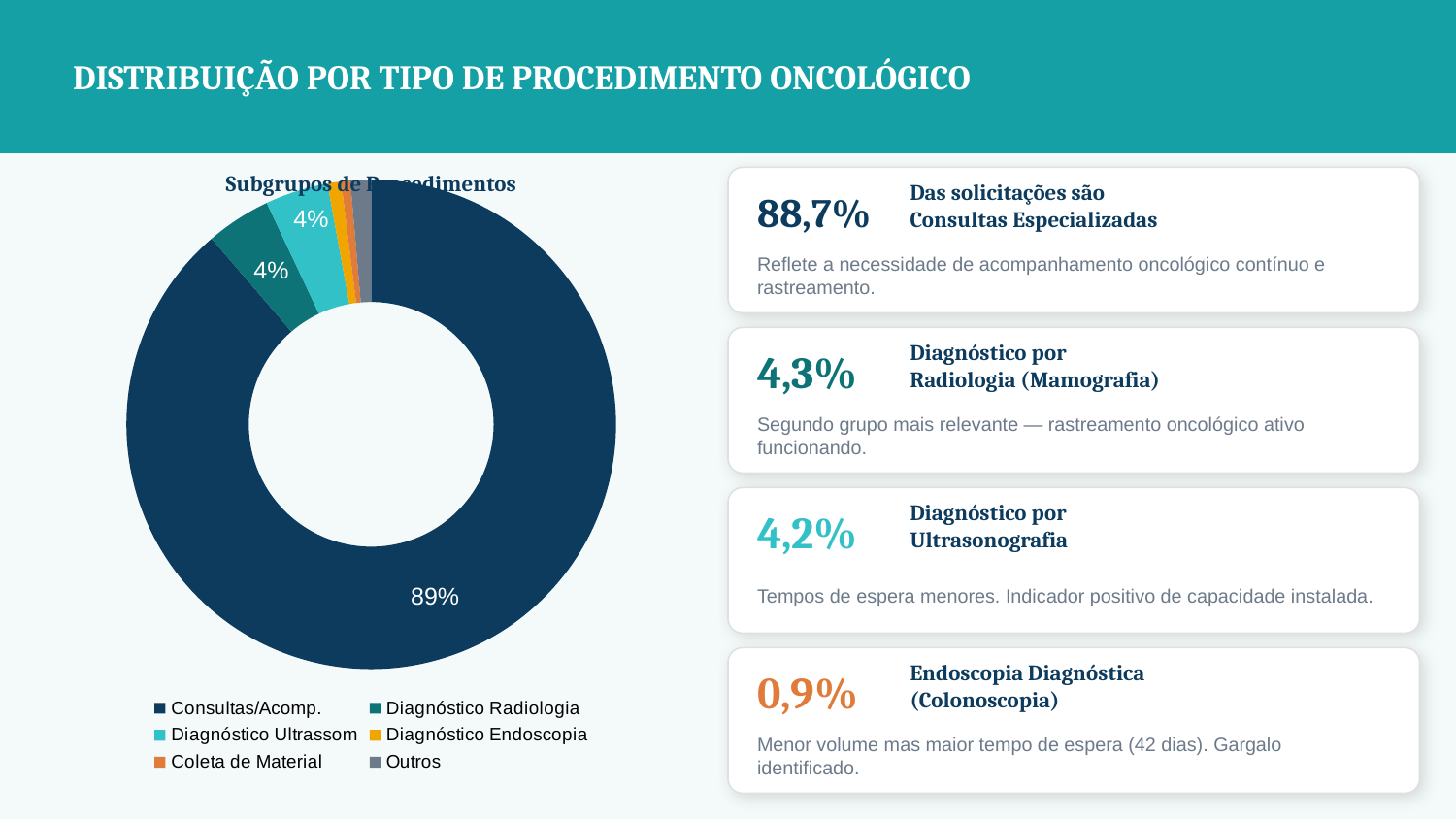
Is the share for Consultas/Acomp. greater or less than 50%? greater What percentage is shown for Diagnóstico Radiologia? 4% Which is larger, the share for Consultas/Acomp. or the share for Diagnóstico Radiologia? Consultas/Acomp. How many categories does the chart's legend list? 6 What percentage is shown for Diagnóstico Ultrassom? 4% Which category has the largest share of the chart? Consultas/Acomp. What is the title of the chart? Subgrupos de Procedimentos What percentage is shown for Consultas/Acomp.? 89% How many slices have a percentage label printed on the chart? 3 Which legend entry is shown in dark blue? Consultas/Acomp. What kind of chart is shown on the slide? Doughnut (pie) chart What is the difference in percentage points between Consultas/Acomp. and Diagnóstico Ultrassom? 85